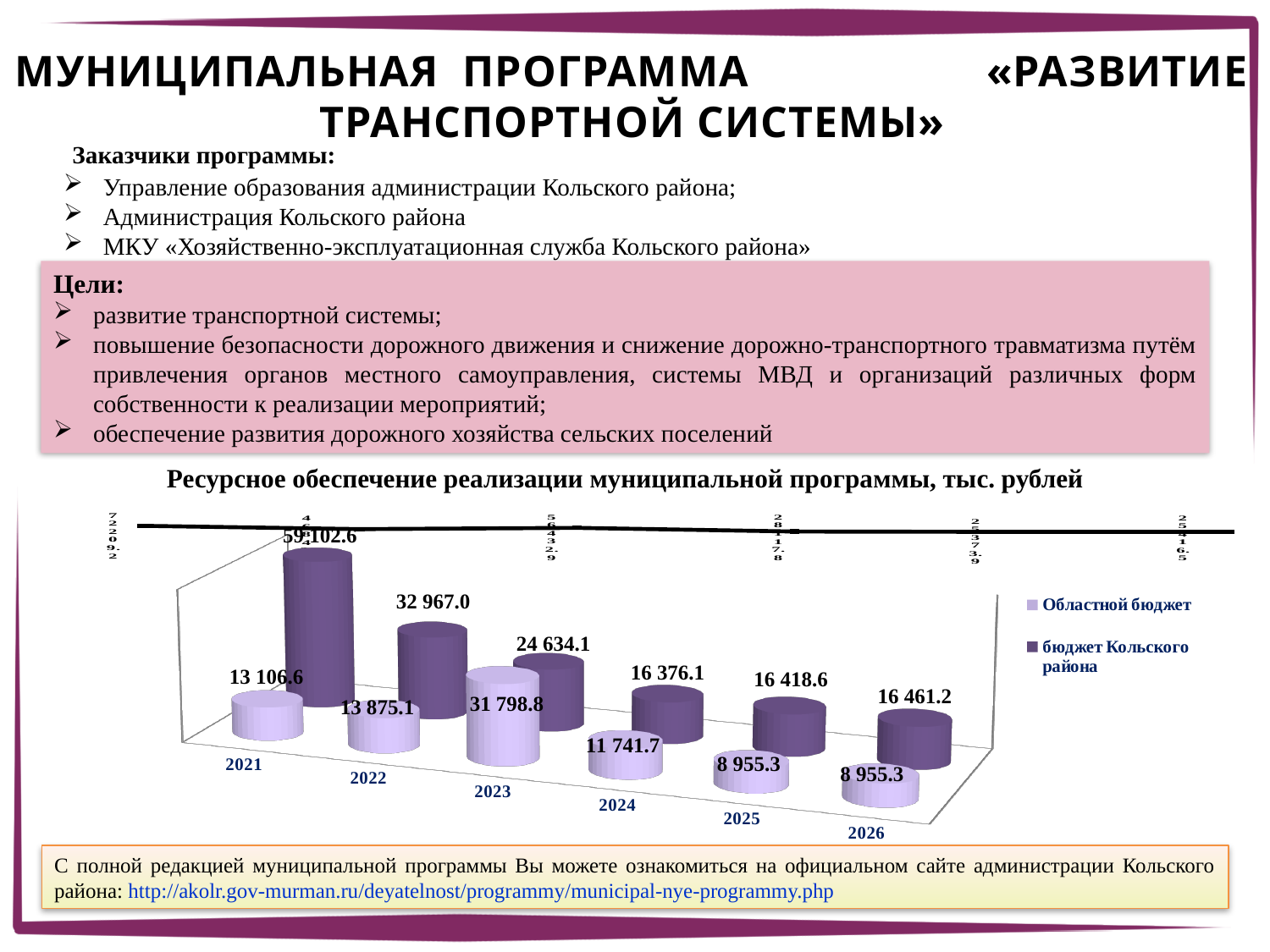
Which is larger in 2023: 'Областной бюджет' or 'бюджет Кольского района'? Областной бюджет What is the difference between 'бюджет Кольского района' and 'Областной бюджет' in 2022? 19 091.9 What is the value for 'Областной бюджет' in 2023? 31 798.8 What is the value for 'бюджет Кольского района' in 2026? 16 461.2 In which year is the 'бюджет Кольского района' value the highest? 2021 How many series does the chart legend list? 2 In which year is the 'Областной бюджет' value the highest? 2023 How many years are shown on the x axis of the chart? 6 What unit is stated in the chart title? тыс. рублей Does the 'бюджет Кольского района' value rise or fall from 2021 to 2024? fall What is the value for 'бюджет Кольского района' in 2021? 59 102.6 What kind of chart is shown on the slide? bar chart